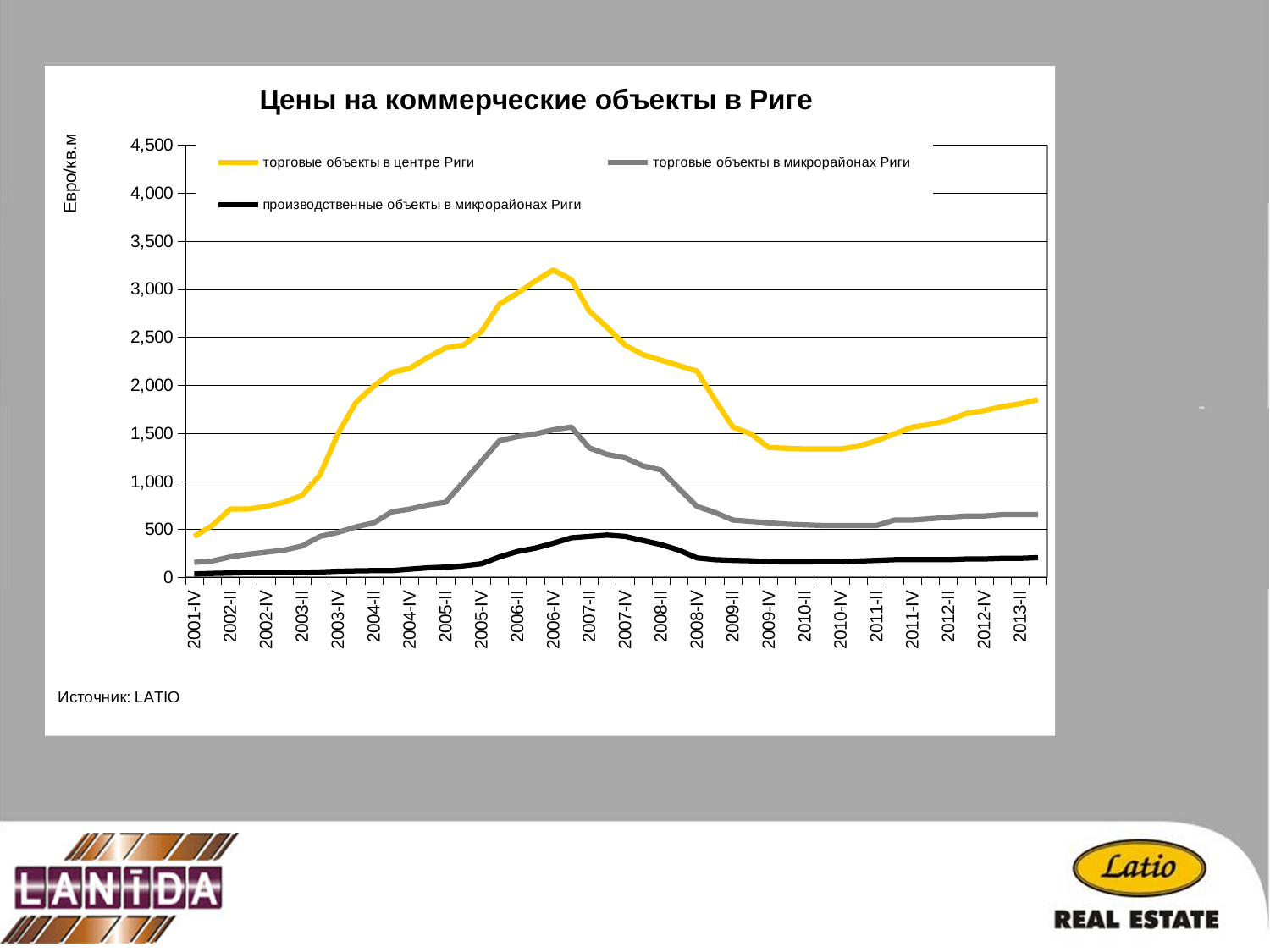
Is the value for торговые объекты в центре Риги at 2006-IV greater or less than 3,000? greater What kind of chart is shown on the slide? line chart In which period does the торговые объекты в центре Риги series reach its peak? 2006-IV Is the value for торговые объекты в микрорайонах Риги at 2006-IV greater or less than 1,000? greater Is the value for торговые объекты в центре Риги at 2001-IV greater or less than 1,000? less Which series has the highest value at 2013-II? торговые объекты в центре Риги What is the label on the vertical axis? Евро/кв.м What is the title of the chart? Цены на коммерческие объекты в Риге How many series does the legend list? 3 Does the торговые объекты в микрорайонах Риги series rise or fall between 2006-IV and 2009-II? fall